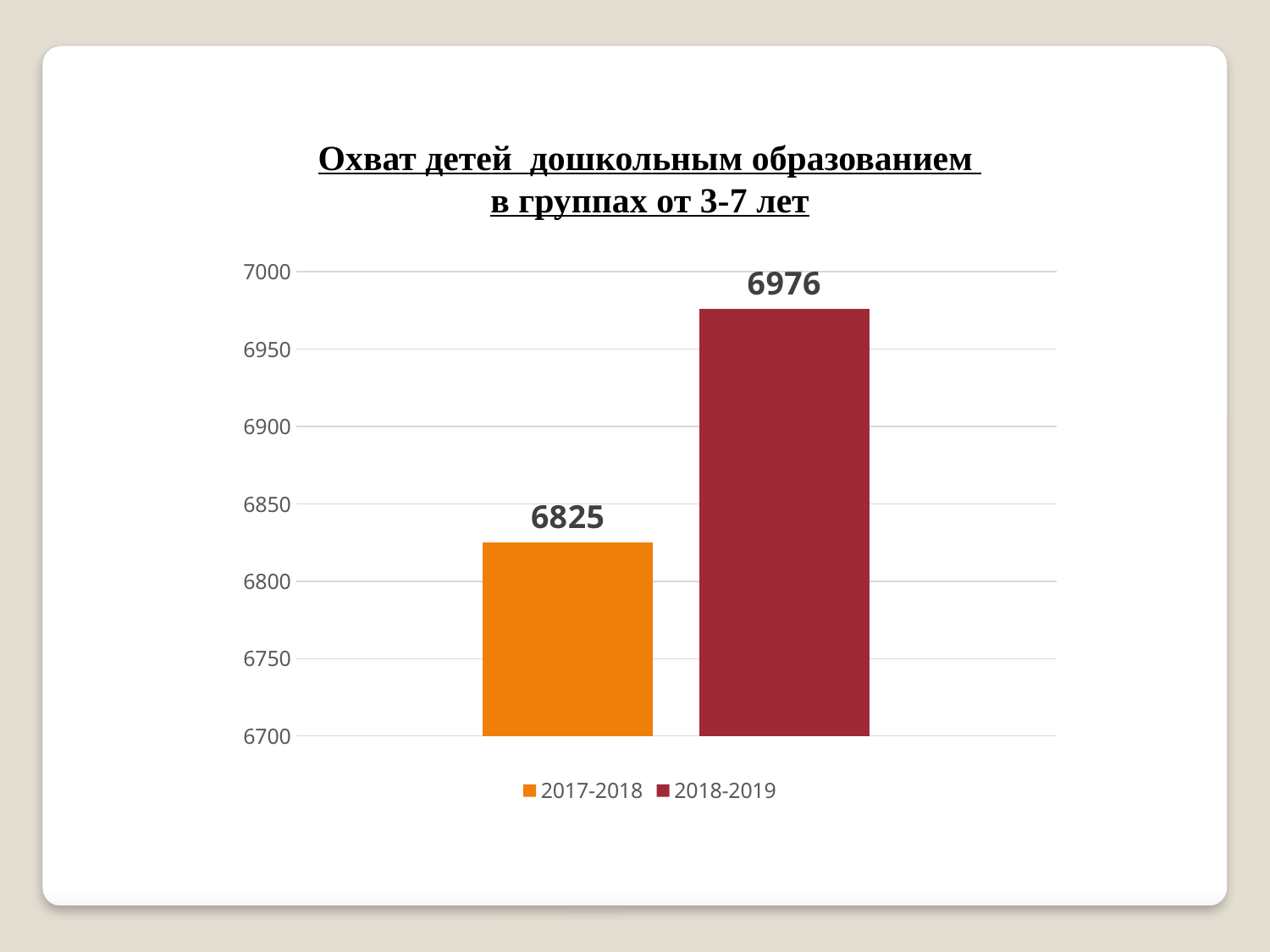
What is the difference between the values for 2018-2019 and 2017-2018? 151 Which is larger, the value for 2017-2018 or the value for 2018-2019? 2018-2019 How many series does the legend list? 2 What is the value for 2017-2018? 6825 What is the value for 2018-2019? 6976 What colour is the bar for 2017-2018? orange Is the value for 2018-2019 greater or less than 6950? greater Which series has the highest value? 2018-2019 Which series has the lowest value? 2017-2018 How many bars are plotted on the chart? 2 What kind of chart is shown on the slide? bar chart Is the value for 2017-2018 greater or less than 6850? less